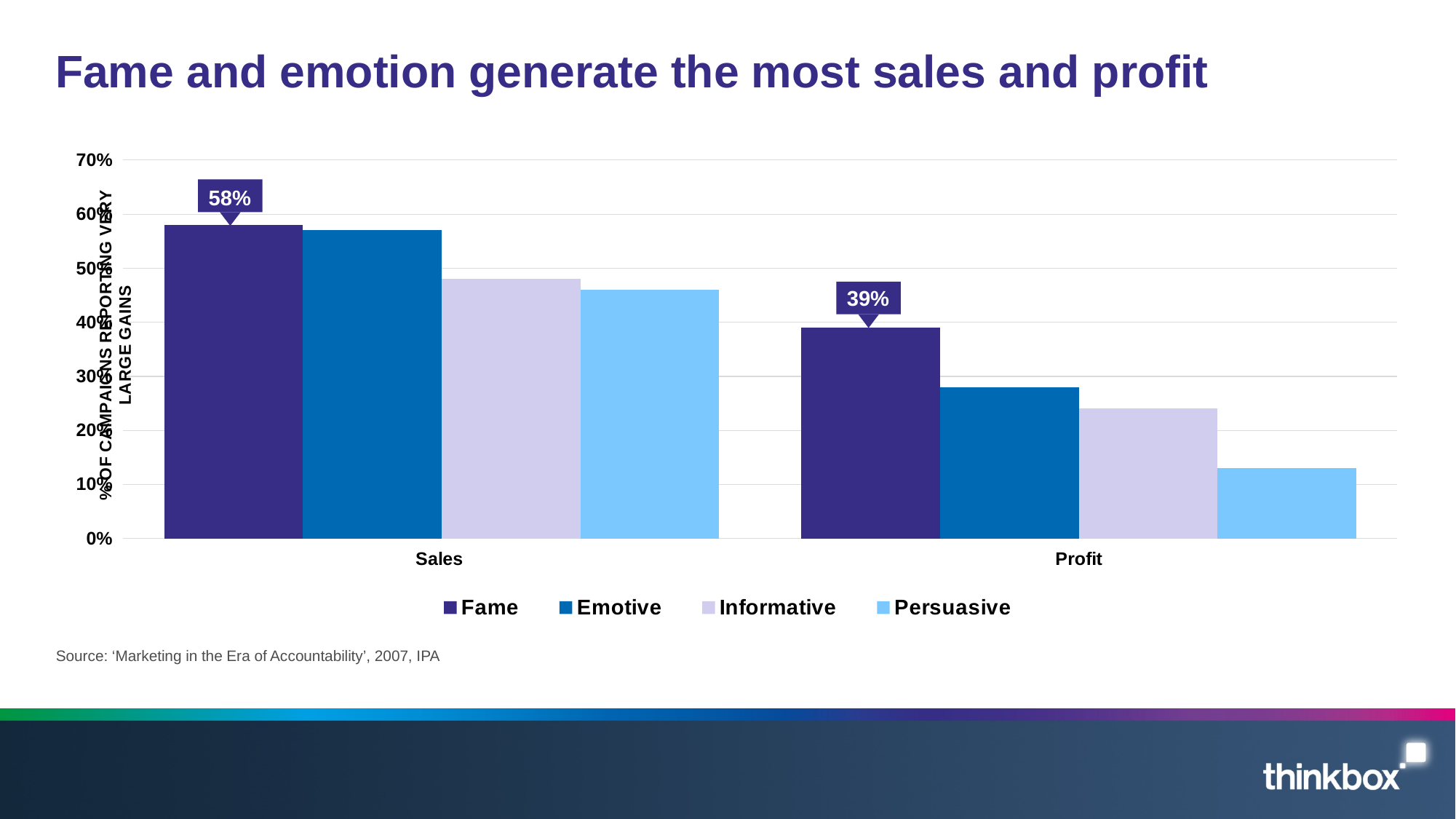
What is the difference between the Fame value for Sales and the Fame value for Profit? 19 percentage points Is the value for Persuasive in the Profit category greater or less than 20%? less Is the value for Emotive in the Sales category greater or less than 50%? greater Which series has the lowest value in the Profit category? Persuasive Which series has the highest value in the Profit category? Fame Is the value for Informative in the Profit category greater or less than 30%? less What is the value for Fame in the Profit category? 39% How many series does the legend list? 4 Is the Fame value larger for Sales or for Profit? Sales What is the value for Fame in the Sales category? 58% How many categories are shown on the x axis? 2 What kind of chart is shown on the slide? bar chart